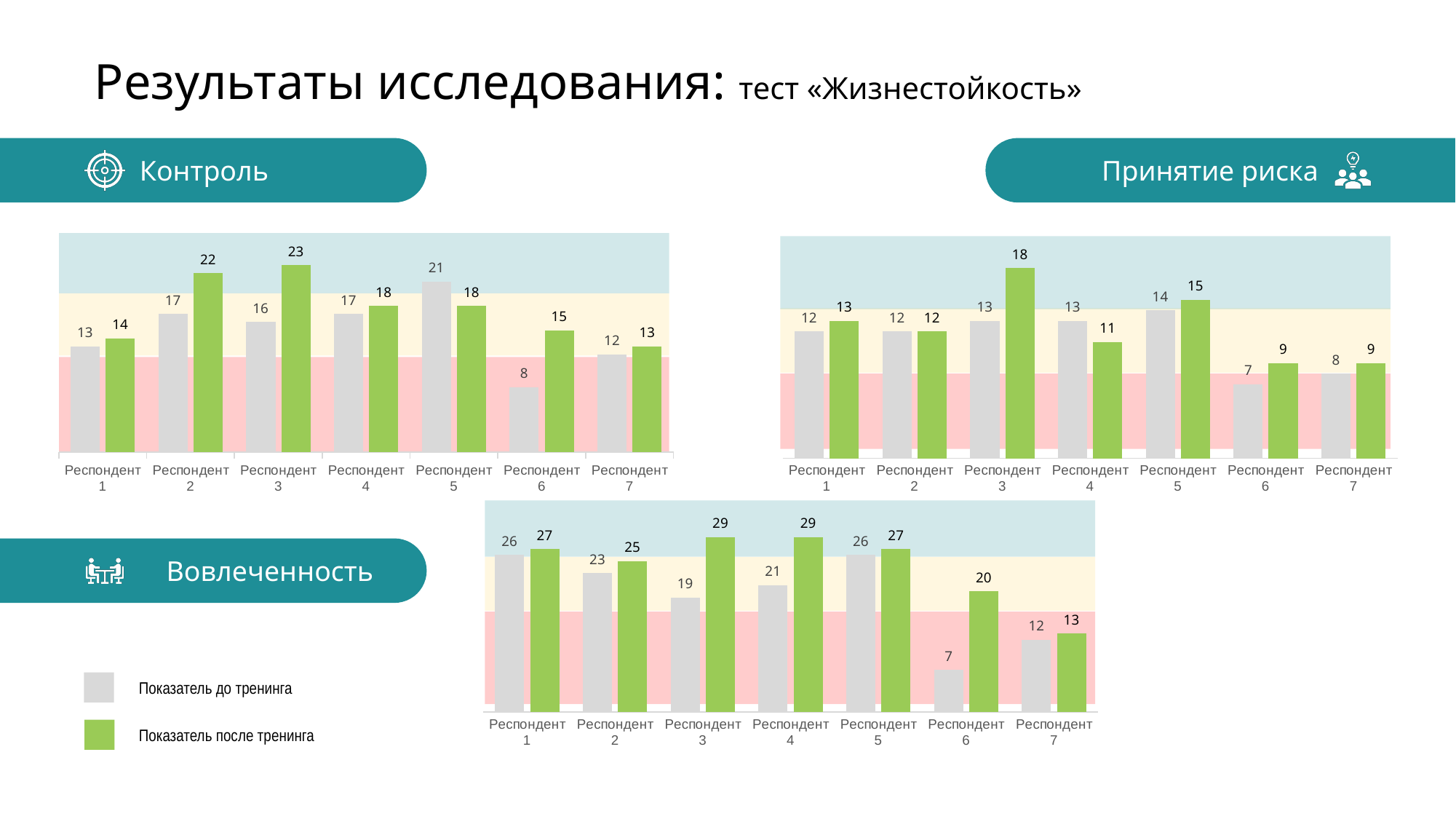
In the «Вовлеченность» chart, what is the value of «Показатель после тренинга» for Респондент 6? 20 In the «Принятие риска» chart, what is the value of «Показатель до тренинга» for Респондент 6? 7 How many series does the legend list for the charts on this slide? 2 In the «Вовлеченность» chart, what is the difference between the after-training and before-training values for Респондент 3? 10 In the «Контроль» chart, what is the value of «Показатель после тренинга» for Респондент 3? 23 In the «Контроль» chart, which respondent has the lowest «Показатель до тренинга»? Респондент 6 In the «Контроль» chart, what is the difference between the after-training and before-training values for Респондент 6? 7 In the «Принятие риска» chart, which respondent has the highest «Показатель после тренинга»? Респондент 3 How many respondents are shown in the «Контроль» chart? 7 In the «Контроль» chart, what is the value of «Показатель до тренинга» for Респондент 5? 21 In the «Вовлеченность» chart, which respondent has the lowest «Показатель после тренинга»? Респондент 7 In the «Принятие риска» chart, for Респондент 4, which is larger: the value before training or after training? Before training (13)